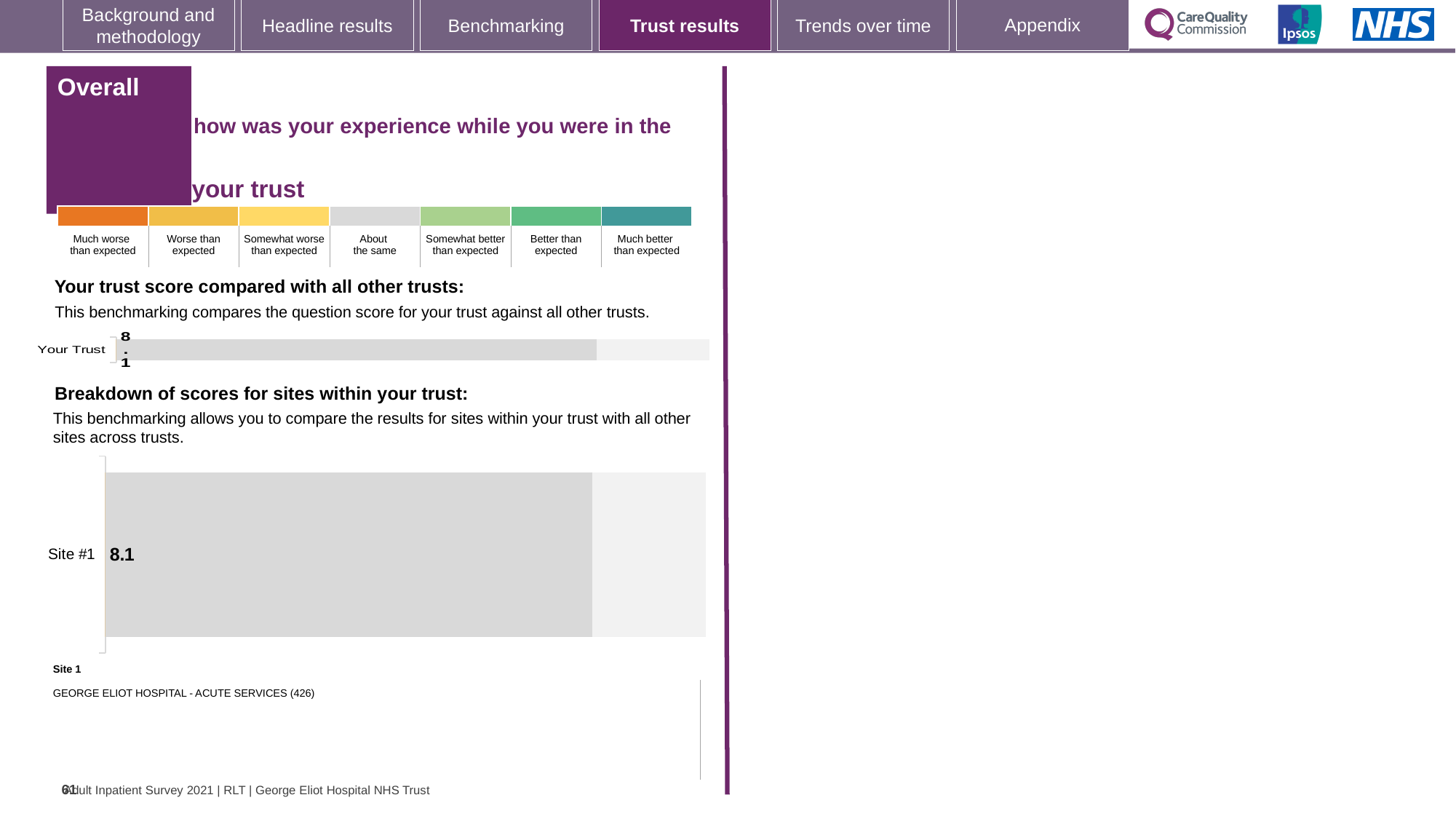
What kind of chart is the 'Your trust score compared with all other trusts' chart? bar chart What is the difference between the Your Trust score in the top chart and the Site #1 score in the bottom chart? 0.0 What kind of chart is the 'Breakdown of scores for sites within your trust' chart? bar chart According to the site key below the 'Breakdown of scores for sites within your trust' chart, which hospital is Site 1? GEORGE ELIOT HOSPITAL - ACUTE SERVICES (426) How many sites are plotted in the 'Breakdown of scores for sites within your trust' chart? 1 In the 'Breakdown of scores for sites within your trust' chart, what is the value for Site #1? 8.1 What is the label of the single bar in the 'Your trust score compared with all other trusts' chart? Your Trust In the 'Your trust score compared with all other trusts' chart, what is the value for Your Trust? 8.1 How many bars are plotted in the 'Your trust score compared with all other trusts' chart? 1